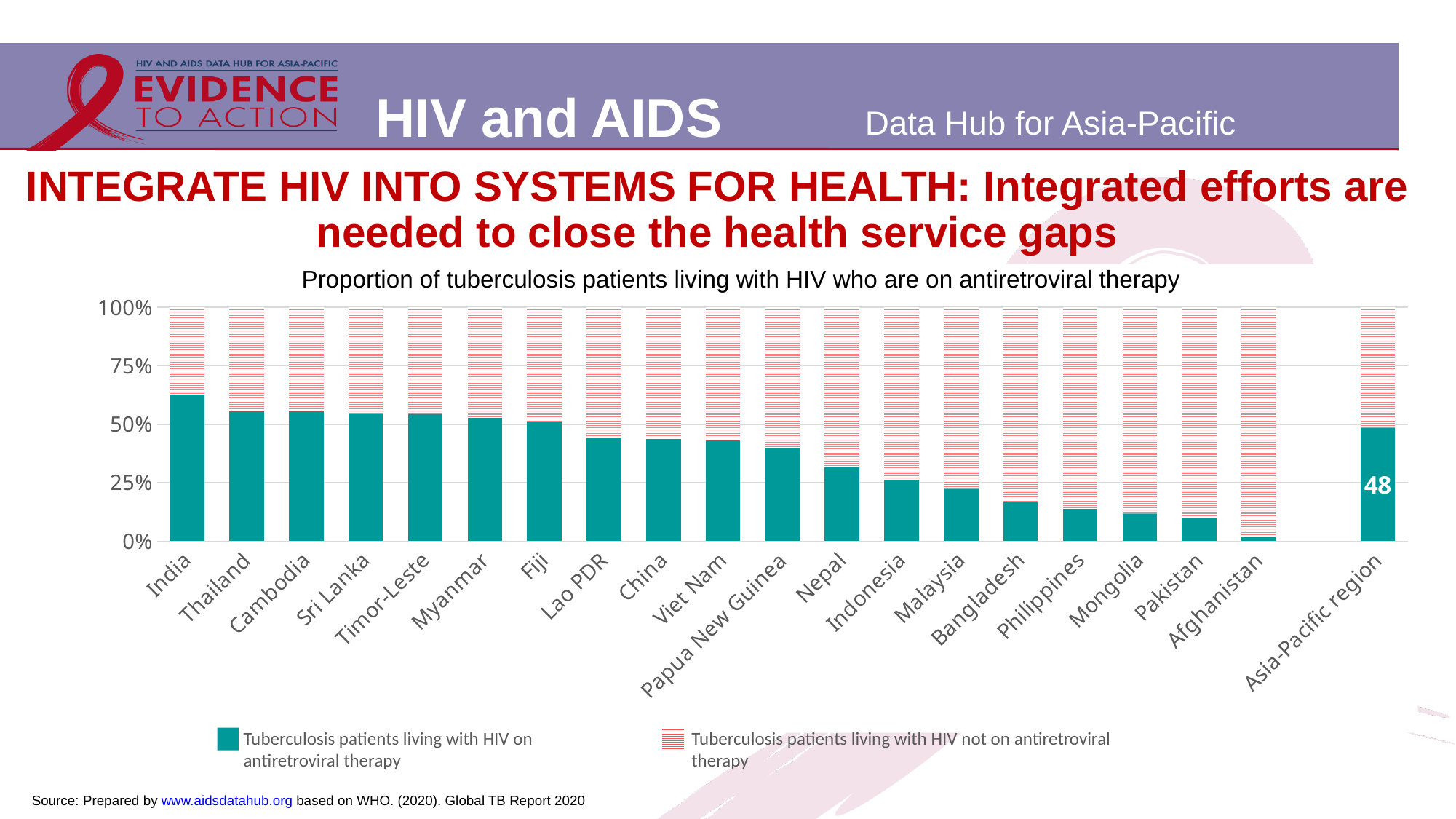
Which country has the highest proportion of tuberculosis patients living with HIV on antiretroviral therapy? India Which country has the lowest proportion of tuberculosis patients living with HIV on antiretroviral therapy? Afghanistan Which has a larger proportion of tuberculosis patients living with HIV on antiretroviral therapy, Thailand or Nepal? Thailand What is the data label shown on the bar for the Asia-Pacific region? 48 Is the proportion of tuberculosis patients living with HIV on antiretroviral therapy for Lao PDR greater or less than 50%? less How many series does the chart legend list? 2 How many categories (countries plus the regional bar) are shown on the x axis of the chart? 20 Is the proportion of tuberculosis patients living with HIV on antiretroviral therapy for India greater or less than 50%? greater What is the title of the chart? Proportion of tuberculosis patients living with HIV who are on antiretroviral therapy Is the proportion of tuberculosis patients living with HIV on antiretroviral therapy for Pakistan greater or less than 25%? less Do the proportions of tuberculosis patients living with HIV on antiretroviral therapy rise or fall from India to Afghanistan along the x axis? Fall What kind of chart is shown on the slide? Stacked bar chart